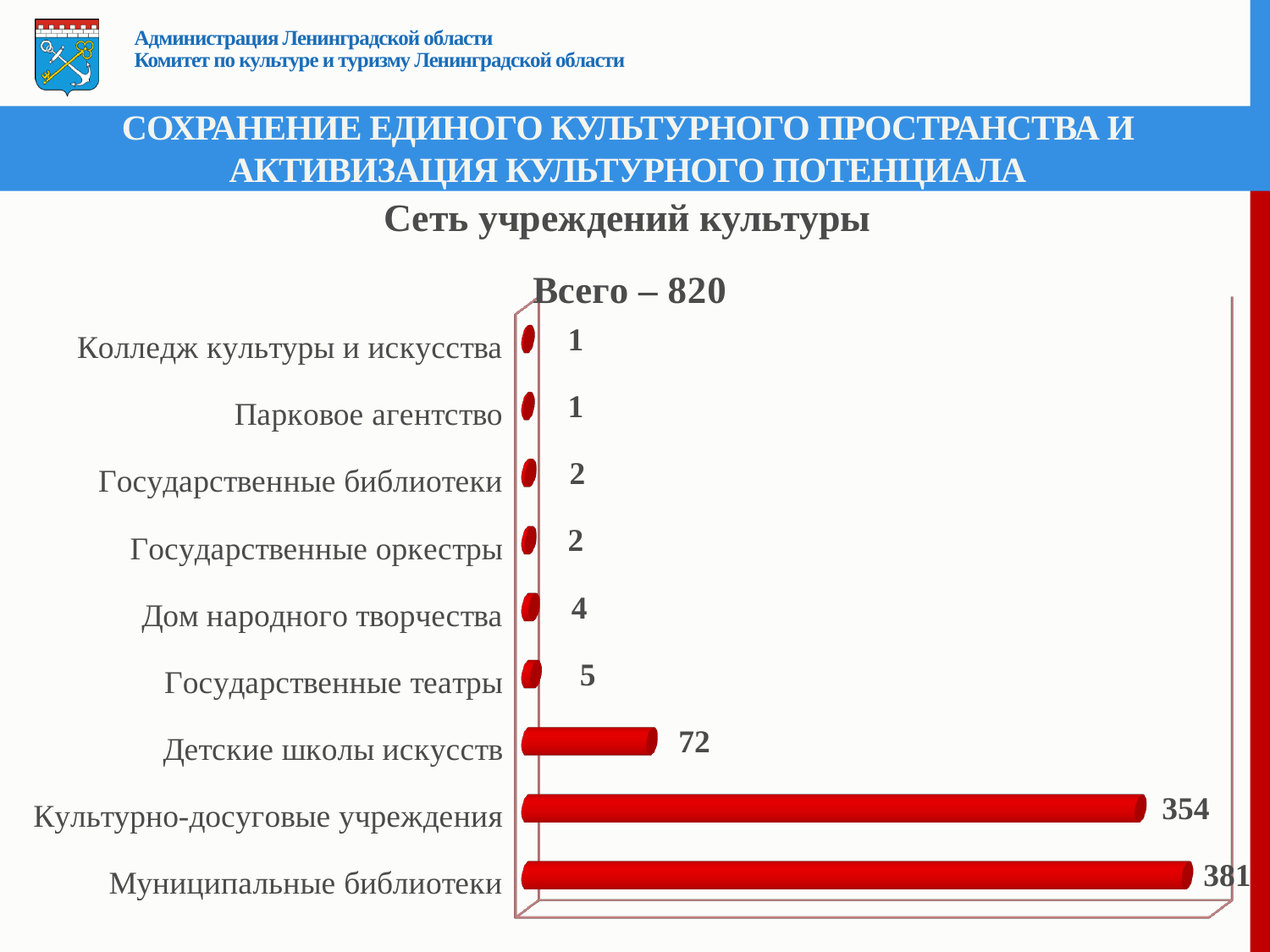
Which category has the highest value? Муниципальные библиотеки What is the value for Государственные театры? 5 What is the value for Культурно-досуговые учреждения? 354 What is the value for Детские школы искусств? 72 Which is larger, the value for Государственные театры or the value for Дом народного творчества? Государственные театры What is the value for Муниципальные библиотеки? 381 What is the value for Дом народного творчества? 4 What total is stated above the chart? Всего – 820 How many categories are shown in the chart? 9 What is the difference between the values for Культурно-досуговые учреждения and Детские школы искусств? 282 What is the difference between the values for Муниципальные библиотеки and Культурно-досуговые учреждения? 27 What kind of chart is shown on the slide? Bar chart